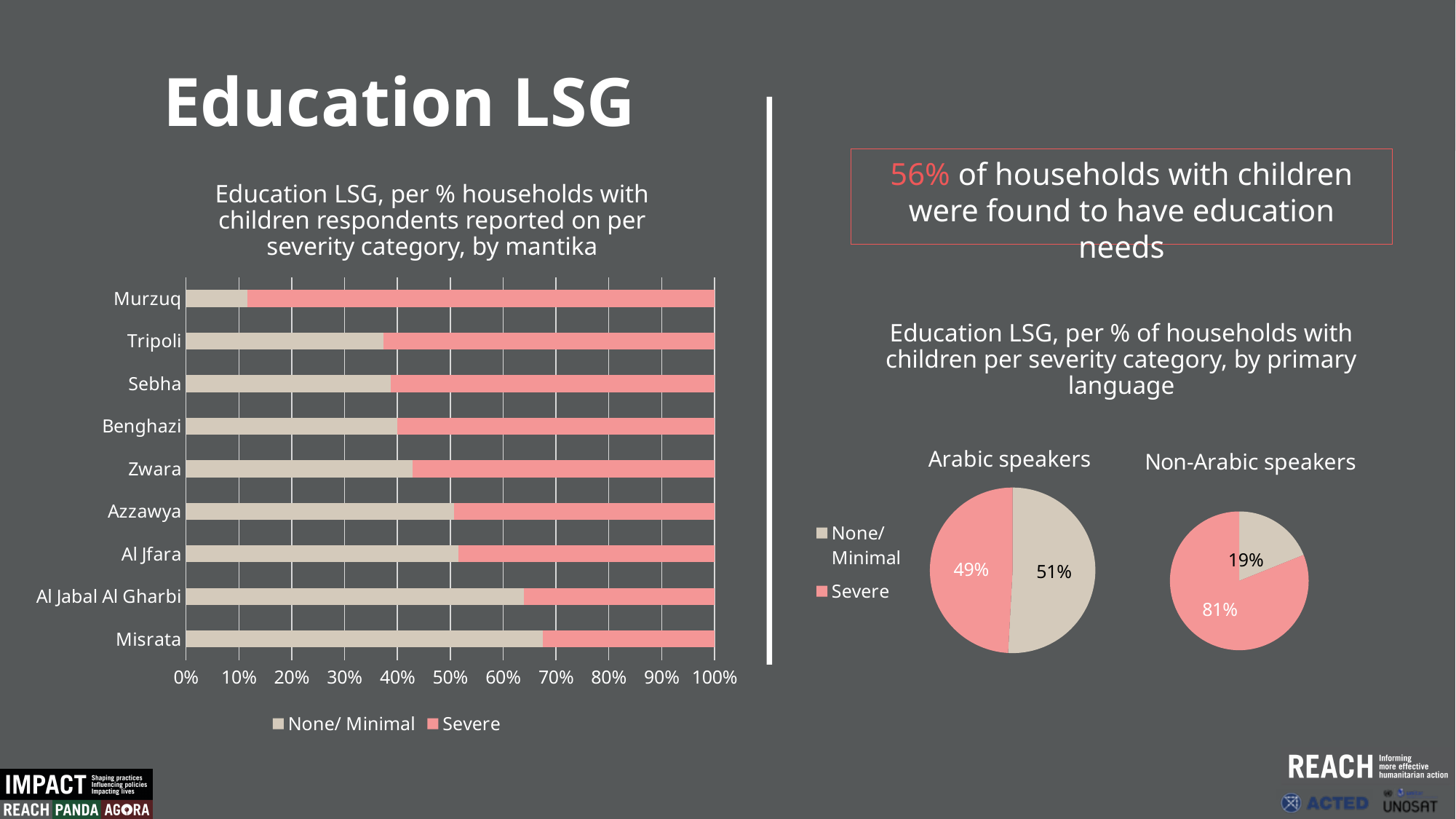
In the 'Arabic speakers' pie chart, what share is None/ Minimal? 51% In the bar chart by mantika, which mantika has the largest None/ Minimal share? Misrata Which pie chart has the larger Severe share, 'Arabic speakers' or 'Non-Arabic speakers'? Non-Arabic speakers In the bar chart 'Education LSG, per % households with children respondents reported on per severity category, by mantika', how many mantikas are listed? 9 In the bar chart by mantika, which has the larger Severe share, Tripoli or Azzawya? Tripoli In the bar chart by mantika, is the None/ Minimal value for Misrata greater or less than 60%? greater In the bar chart by mantika, which mantika has the largest Severe share? Murzuq In the 'Non-Arabic speakers' pie chart, what is the difference between the Severe and None/ Minimal shares? 62 percentage points In the bar chart by mantika, how many series does the legend list? 2 In the bar chart by mantika, is the None/ Minimal value for Murzuq greater or less than 20%? less What kind of chart is the chart by mantika on the left of the slide? Stacked bar chart In the 'Non-Arabic speakers' pie chart, what share is Severe? 81%